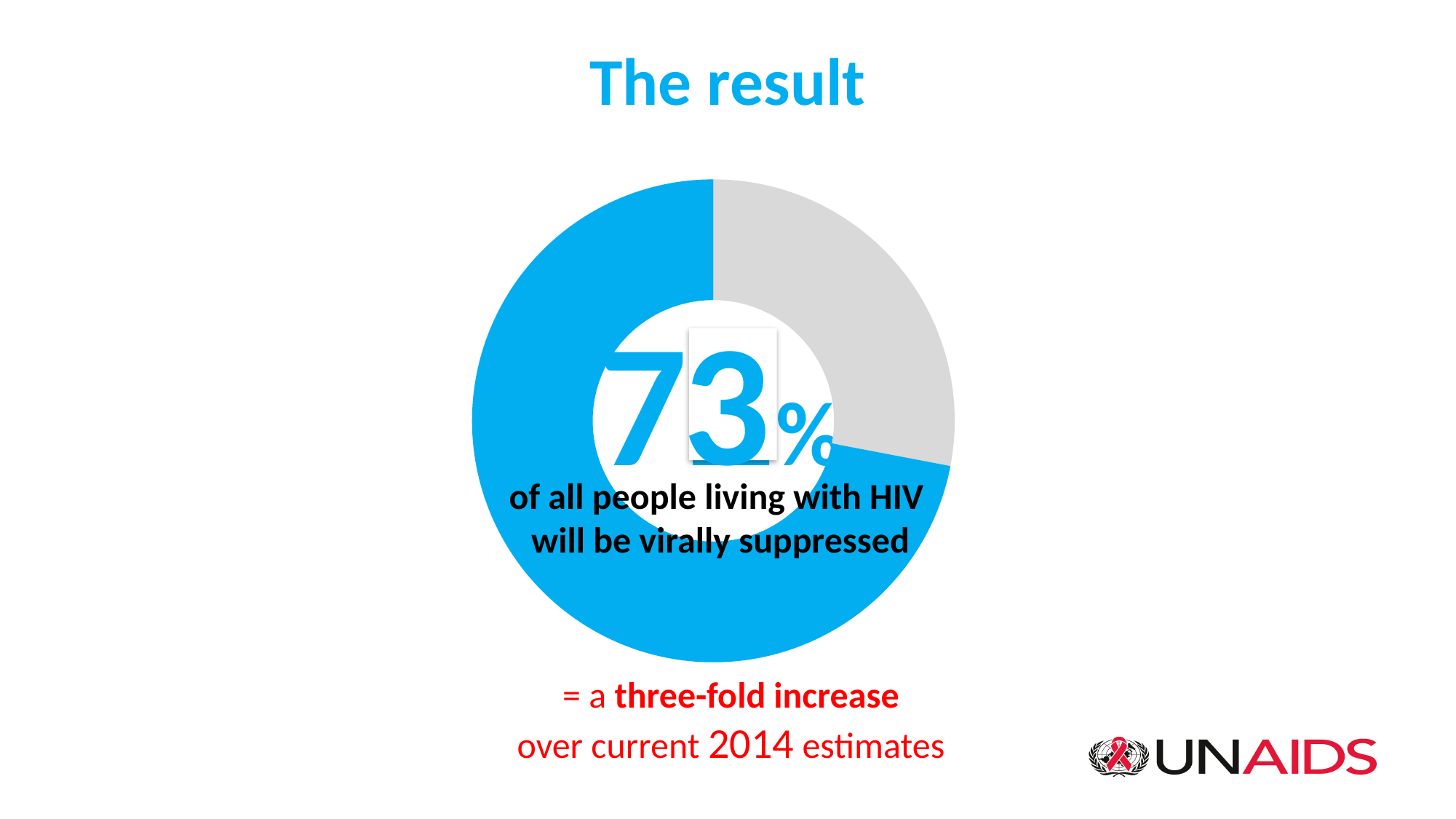
What colour is the slice representing the 73% share? Blue How many slices does the donut chart have? 2 What value is printed in the centre of the donut chart? 73% What kind of chart is shown on the slide? Pie chart (donut) What percentage of all people living with HIV will be virally suppressed, according to the chart? 73% Is the blue slice of the donut chart greater or less than half of the chart? greater What is the title of the slide containing the chart? The result Which slice of the donut chart is larger, the blue slice or the grey slice? The blue slice